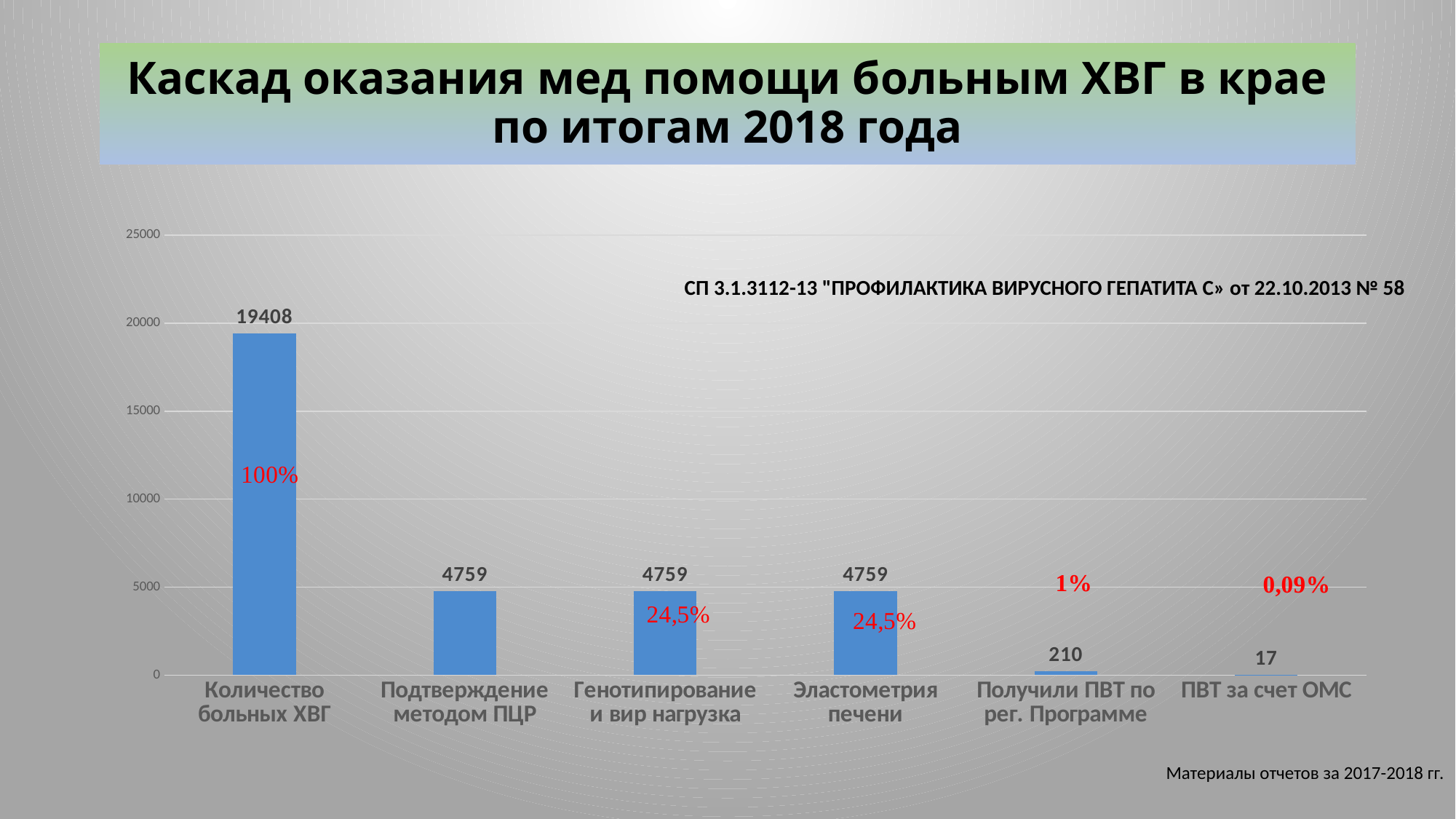
What is the value for ПВТ за счет ОМС? 17 Which category has the lowest value? ПВТ за счет ОМС What is the value for Подтверждение методом ПЦР? 4759 What is the difference between Количество больных ХВГ and Подтверждение методом ПЦР? 14649 Is the value for Генотипирование и вир нагрузка greater or less than 5000? less Which is larger, Эластометрия печени or Получили ПВТ по рег. Программе? Эластометрия печени What is the value for Количество больных ХВГ? 19408 How many categories are shown on the x axis? 6 Which category has the highest value? Количество больных ХВГ What is the value for Получили ПВТ по рег. Программе? 210 What is the difference between Получили ПВТ по рег. Программе and ПВТ за счет ОМС? 193 What kind of chart is shown on the slide? bar chart